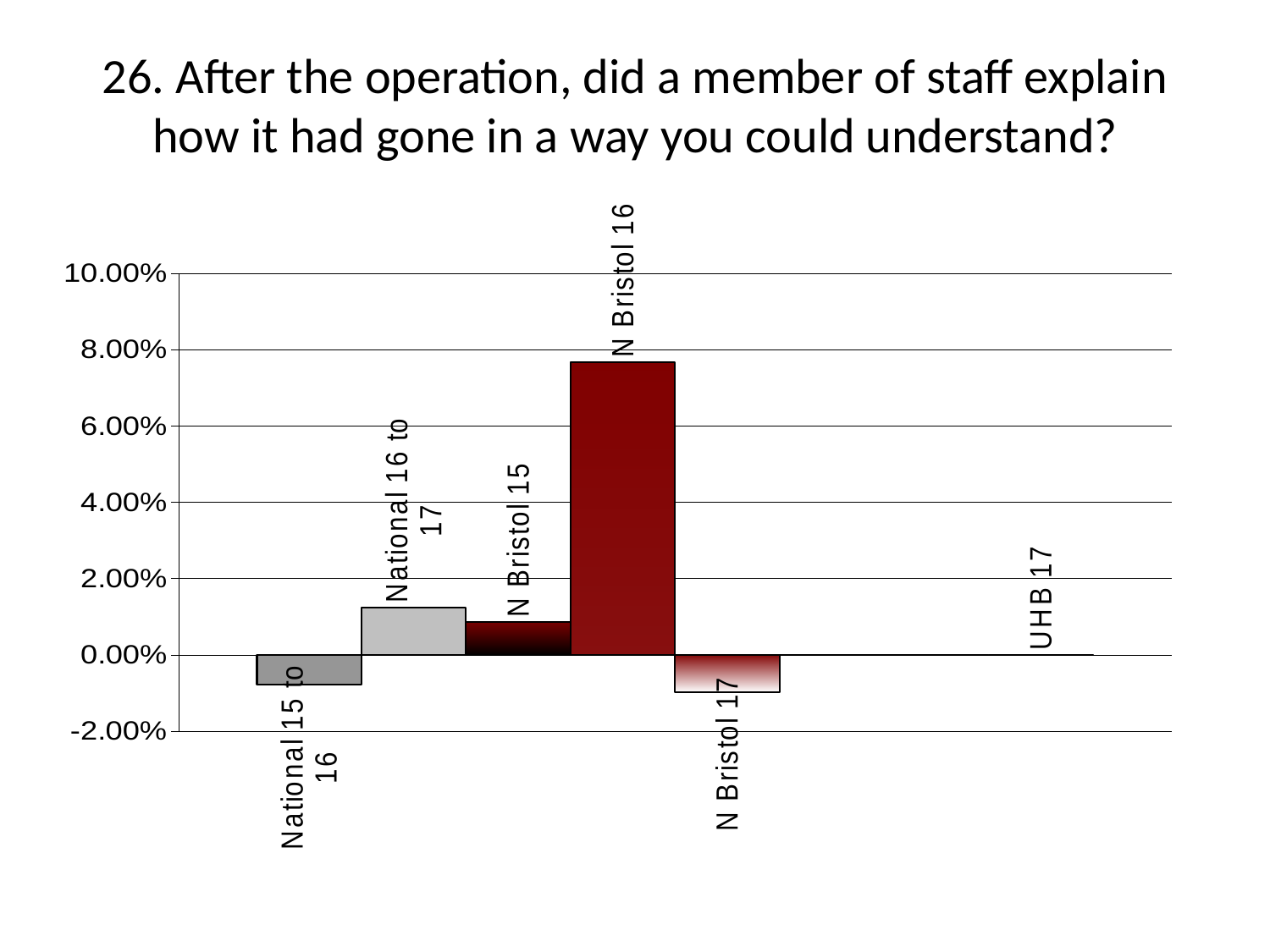
How many categories are shown on the x axis of the chart? 6 What kind of chart is shown on the slide? bar chart Is the value for N Bristol 16 greater or less than 6.00%? greater How many categories have a value below 0.00%? 2 Which is larger, the value for N Bristol 16 or the value for National 16 to 17? N Bristol 16 Is the value for N Bristol 17 greater or less than 0.00%? less Which is larger, the value for National 16 to 17 or the value for N Bristol 15? National 16 to 17 Is the value for National 16 to 17 greater or less than 2.00%? less What is the title of the slide? 26. After the operation, did a member of staff explain how it had gone in a way you could understand? Which category has the highest value in the chart? N Bristol 16